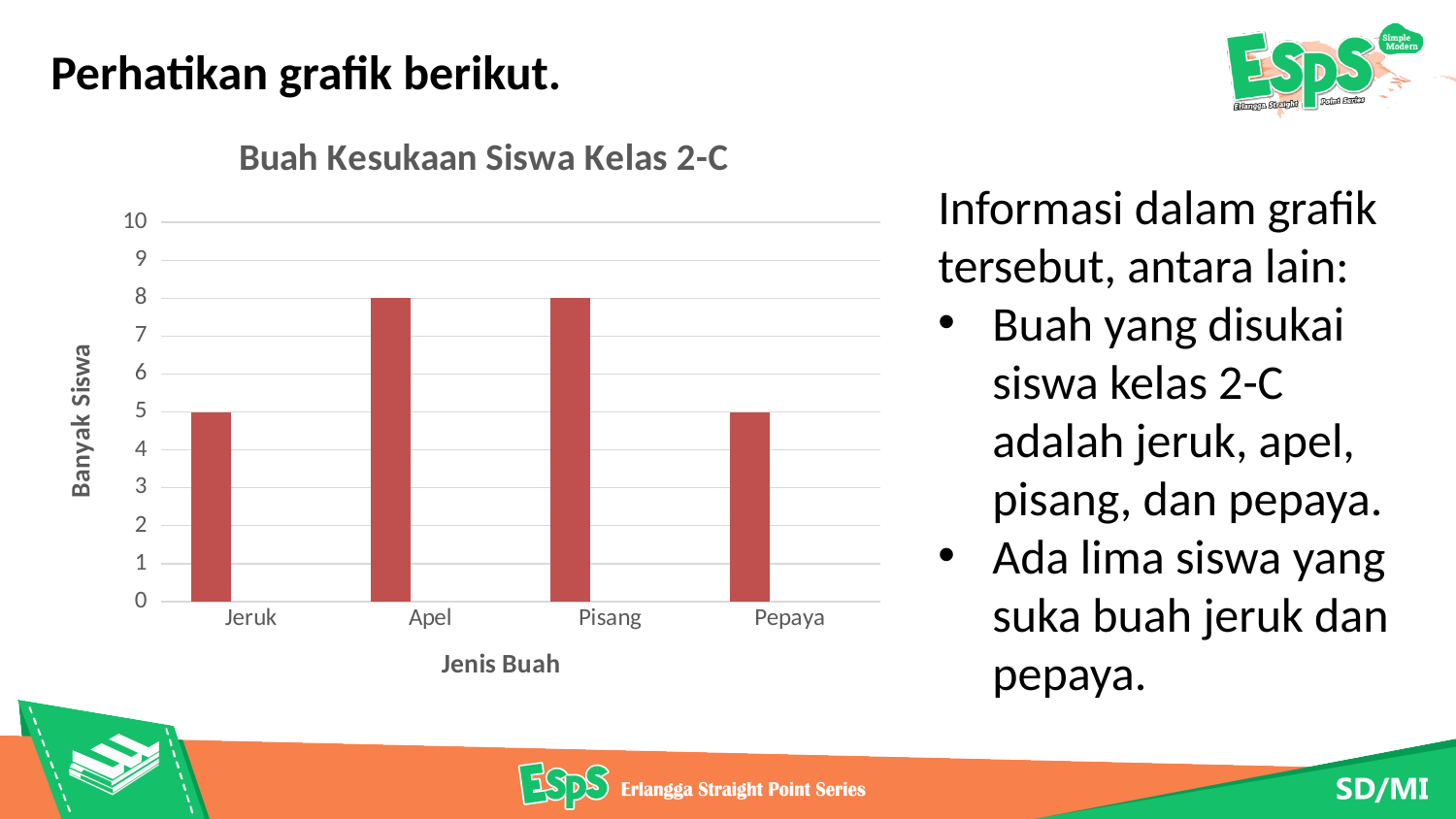
How many students chose Jeruk as their favourite fruit? 5 Which is larger, the value for Pepaya or the value for Pisang? Pisang Which is larger, the value for Apel or the value for Jeruk? Apel What is the label of the vertical axis? Banyak Siswa What is the difference between the values for Pisang and Pepaya? 3 How many students chose Pepaya? 5 What is the title of the chart? Buah Kesukaan Siswa Kelas 2-C What is the value of the bar for Apel? 8 What is the value of the bar for Pisang? 8 What is the difference between the values for Apel and Jeruk? 3 How many fruit categories are shown on the x axis? 4 What kind of chart is shown on the slide? Bar chart